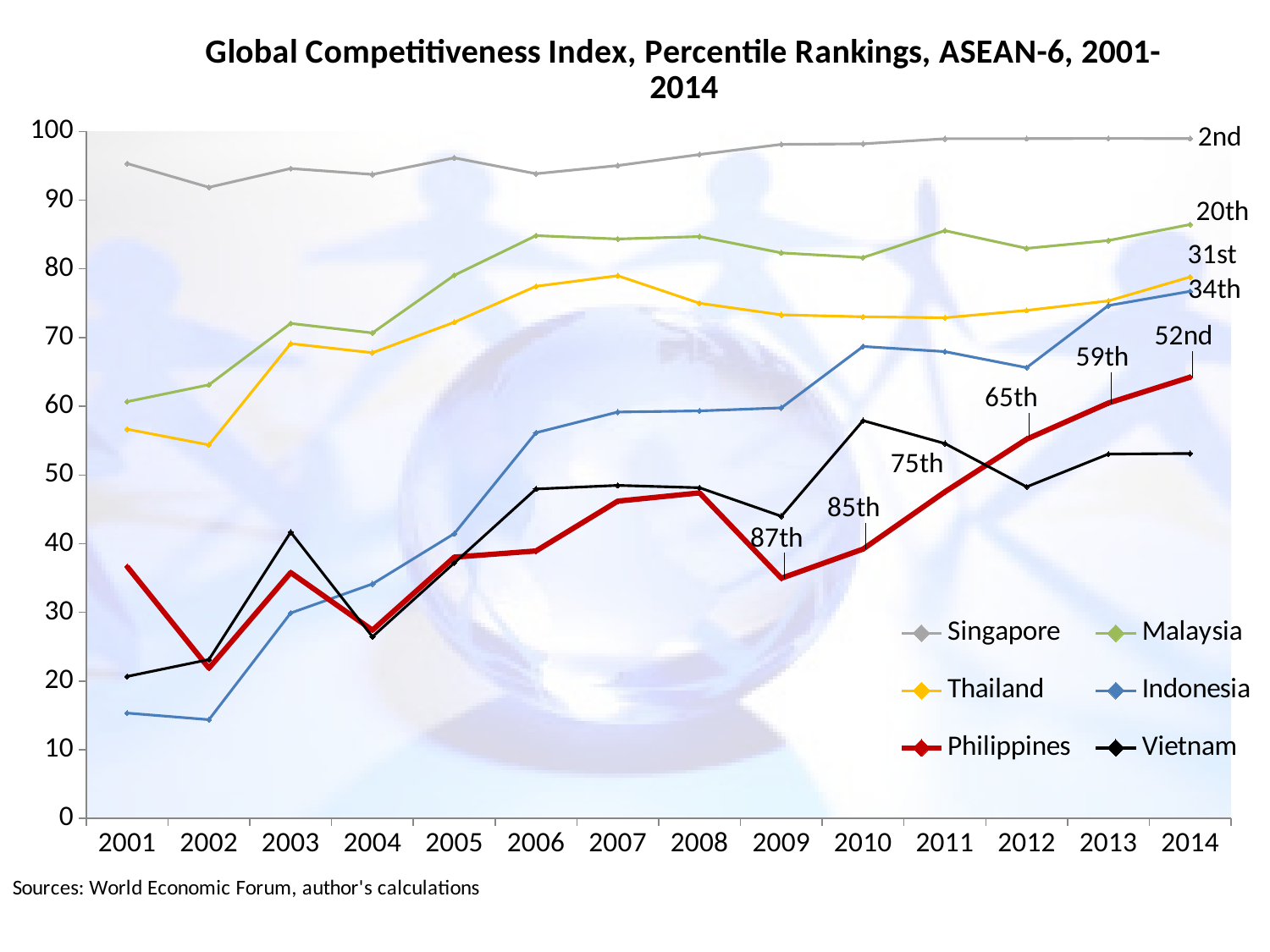
Which country has the lowest percentile ranking in 2014? Vietnam Is the value for Vietnam in 2001 greater or less than 30? less What rank label is shown for the Philippines in 2014? 52nd What kind of chart is shown on the slide? line chart Is the value for Singapore in 2014 greater or less than 90? greater How many years are shown along the x axis? 14 Which country has the lowest percentile ranking in 2001? Indonesia How many series does the legend list? 6 In 2014, which is higher, Malaysia or Thailand? Malaysia Is the value for the Philippines in 2009 greater or less than 40? less Does the Philippines line rise or fall from 2009 to 2014? rise Which country has the highest percentile ranking in 2014? Singapore